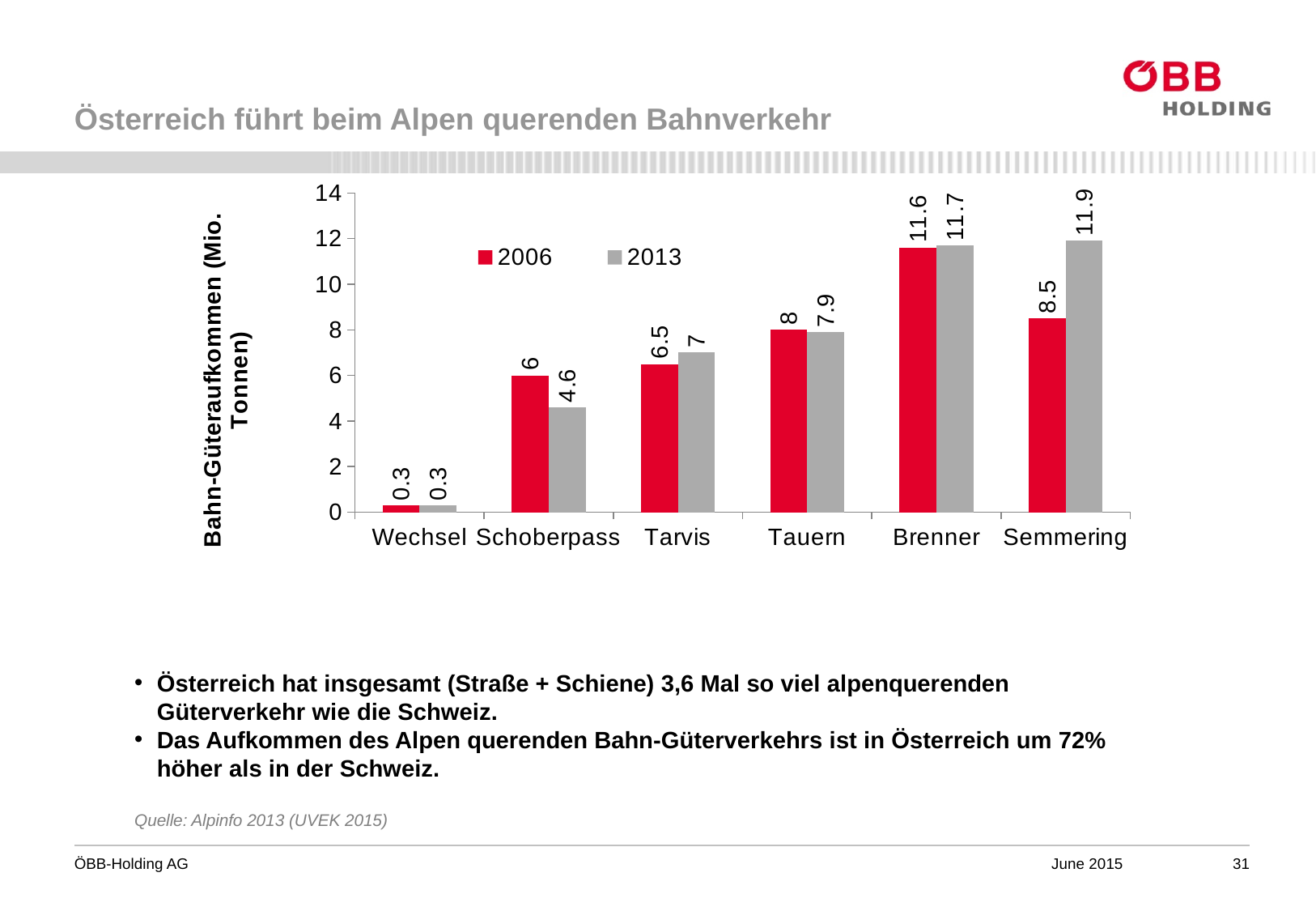
Which category has the highest 2013 value? Semmering What is the label of the y axis? Bahn-Güteraufkommen (Mio. Tonnen) How many categories are shown on the x axis? 6 What is the 2006 value for Semmering? 8.5 Which is larger for Tarvis, the 2006 value or the 2013 value? 2013 What is the 2013 value for Tauern? 7.9 How many series does the legend list? 2 What kind of chart is shown on the slide? Bar chart What is the difference between the 2006 and 2013 values for Schoberpass? 1.4 What is the difference between the 2013 and 2006 values for Semmering? 3.4 What is the 2013 value for Schoberpass? 4.6 Which category has the lowest 2006 value? Wechsel